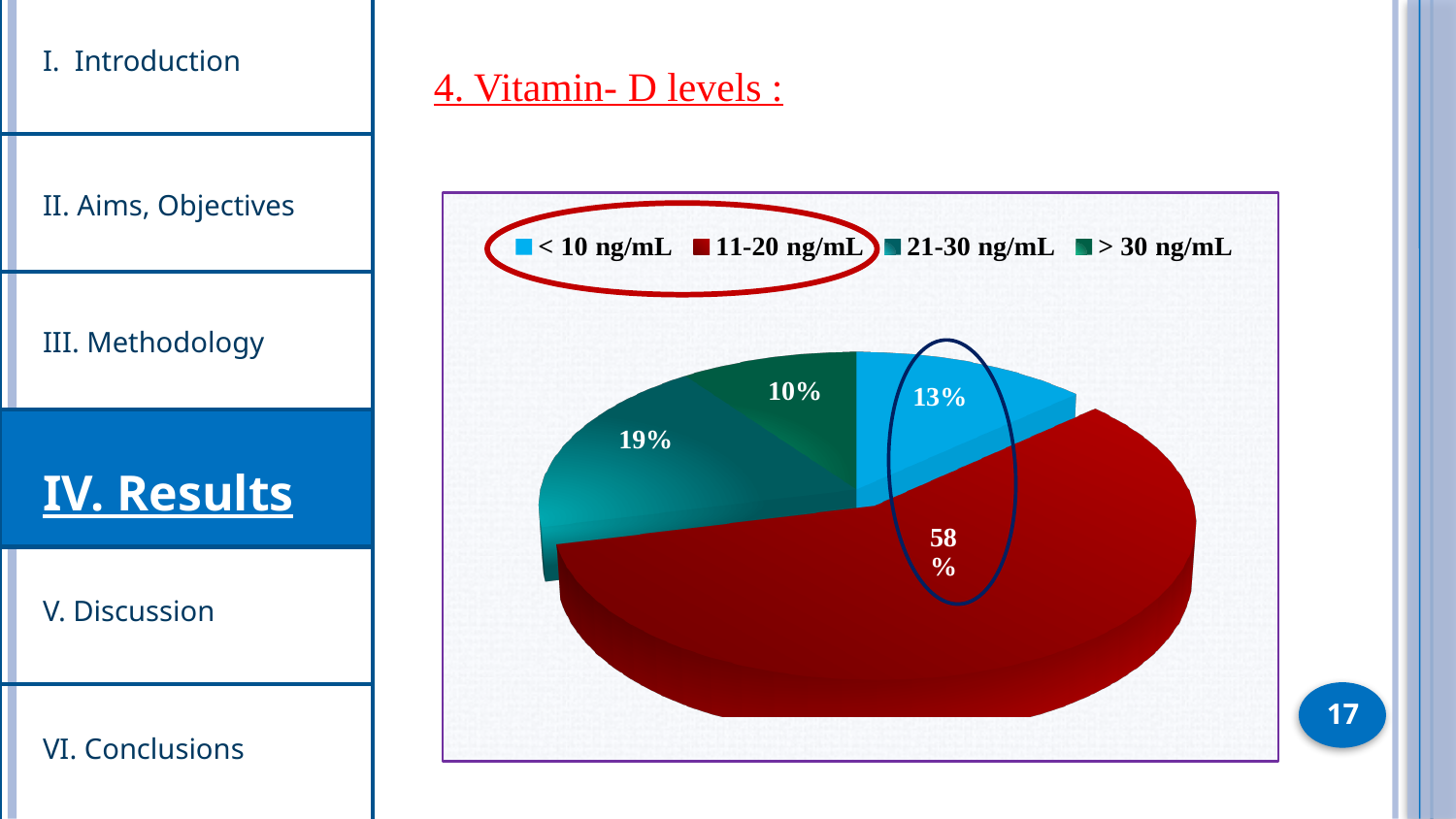
What kind of chart is shown on the slide? Pie chart What percentage of the pie corresponds to the 21-30 ng/mL category? 19% Which category has the smallest share of the pie? > 30 ng/mL What percentage of the pie corresponds to the > 30 ng/mL category? 10% What colour is the slice for the 11-20 ng/mL category? Red What percentage of the pie corresponds to the < 10 ng/mL category? 13% What is the difference in percentage points between the 11-20 ng/mL slice and the 21-30 ng/mL slice? 39 Which slice is larger: 21-30 ng/mL or < 10 ng/mL? 21-30 ng/mL What percentage of the pie corresponds to the 11-20 ng/mL category? 58% How many categories does the legend list? 4 Which category has the largest share of the pie? 11-20 ng/mL What is the title of the chart section on the slide? 4. Vitamin- D levels :